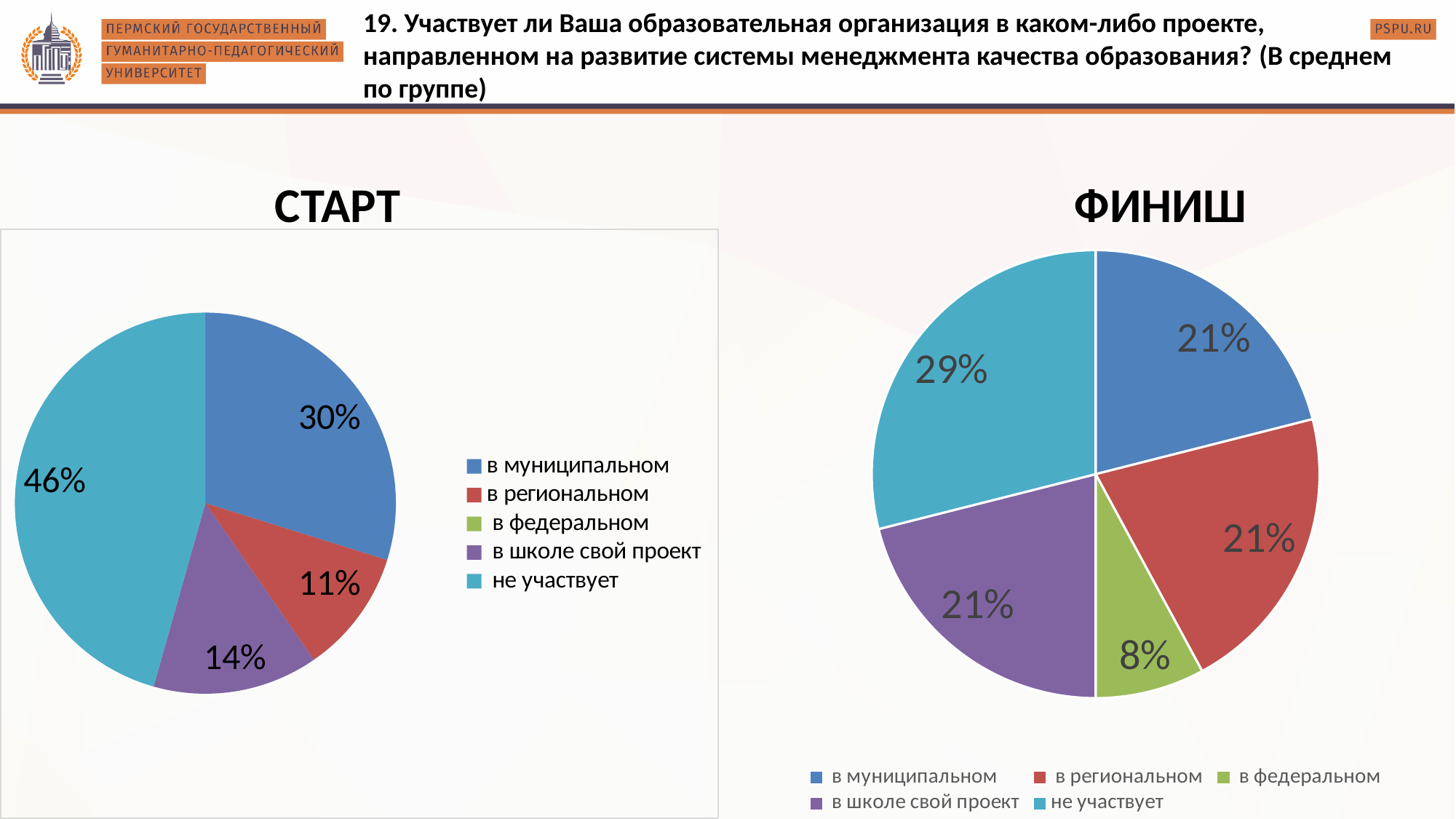
In the СТАРТ pie chart, what is the difference between the 'не участвует' share and the 'в муниципальном' share? 16% In the СТАРТ pie chart, which is larger: the 'в региональном' slice or the 'в школе свой проект' slice? в школе свой проект What type of chart is the ФИНИШ chart? pie chart In the СТАРТ pie chart, what share is labelled for 'в школе свой проект'? 14% In the ФИНИШ pie chart, what is the difference between the 'не участвует' share and the 'в федеральном' share? 21% How many entries does the legend of the ФИНИШ chart list? 5 In the ФИНИШ pie chart, what share is labelled for 'в федеральном'? 8% In the ФИНИШ pie chart, what share is labelled for 'не участвует'? 29% In the ФИНИШ pie chart, which category has the smallest slice? в федеральном In the СТАРТ pie chart, what share is labelled for 'в муниципальном'? 30% In the СТАРТ pie chart, what share is labelled for 'не участвует'? 46% In the СТАРТ pie chart, which category has the largest slice? не участвует